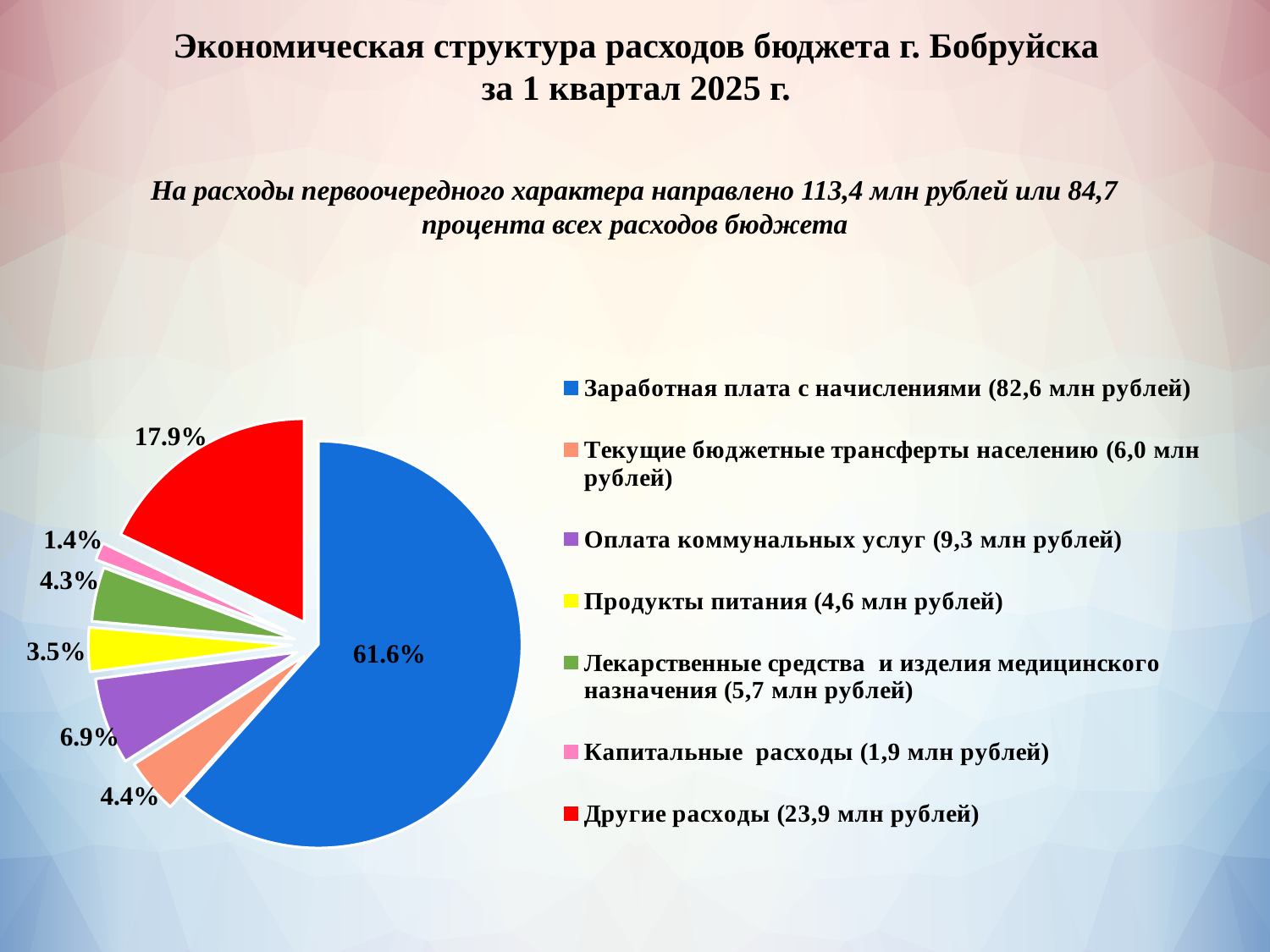
What kind of chart is shown on the slide? pie chart What share of the pie does "Заработная плата с начислениями" take? 61.6% What colour is the slice for "Другие расходы"? red What share of the pie does "Оплата коммунальных услуг" take? 6.9% What share of the pie does "Другие расходы" take? 17.9% How many slices does the pie chart have? 7 Which slice is larger: "Продукты питания" or "Лекарственные средства и изделия медицинского назначения"? Лекарственные средства и изделия медицинского назначения Which category has the largest slice of the pie? Заработная плата с начислениями Which category has the smallest slice of the pie? Капитальные расходы According to the legend, how many million rubles were spent on "Продукты питания"? 4,6 млн рублей What is the difference in percentage points between the "Другие расходы" slice and the "Оплата коммунальных услуг" slice? 11.0